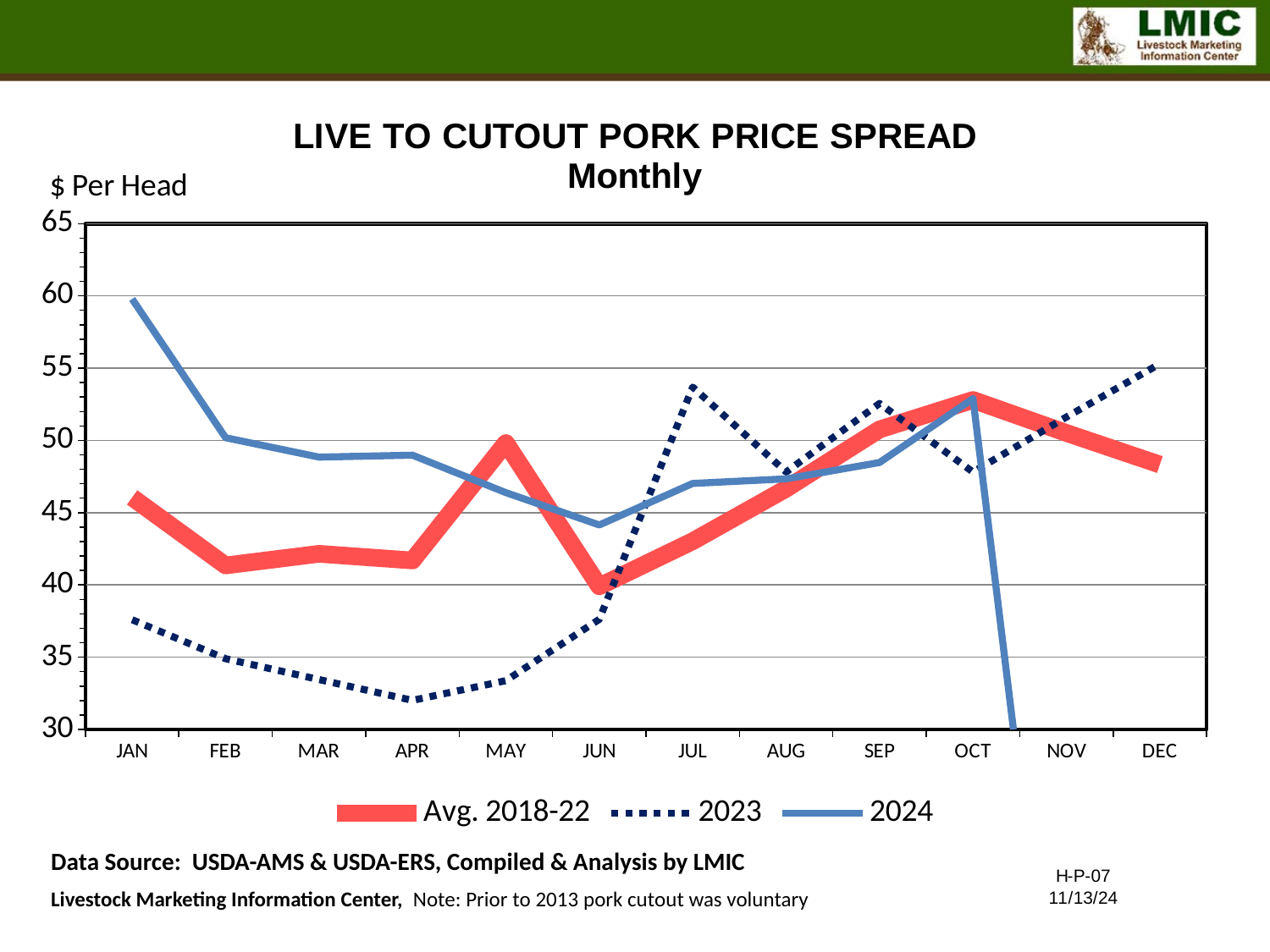
How many months are shown along the x axis? 12 What kind of chart is shown on the slide? line chart What unit is shown on the y axis label? $ Per Head Is the Avg. 2018-22 value for JUN greater or less than 45? less Is the 2024 value for JAN greater or less than 55? greater Is the 2023 value for APR greater or less than 35? less How many series does the legend list? 3 In JUL, which series has the higher value: 2023 or Avg. 2018-22? 2023 Does the 2023 series rise or fall from JAN to APR? fall In which month is the Avg. 2018-22 series at its highest? OCT In JAN, which series has the higher value: 2024 or Avg. 2018-22? 2024 In which month is the 2023 series at its lowest? APR